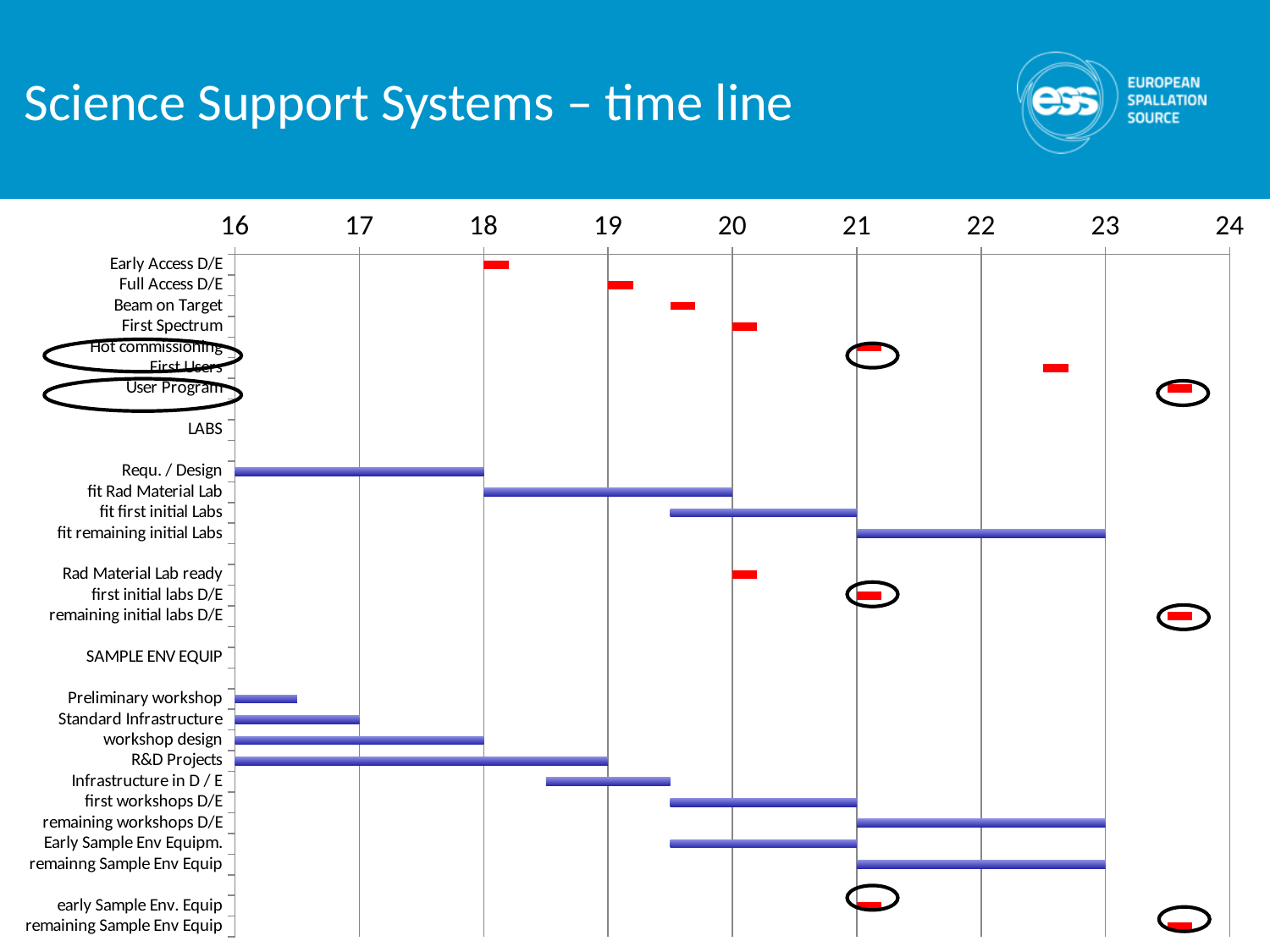
In which year does the Standard Infrastructure bar end? 17 Is the end of the Preliminary workshop bar before or after year 17? before What is the title of the slide containing the chart? Science Support Systems – time line In which year does the Requ. / Design bar end? 18 At which year is the Early Access D/E milestone marker placed? 18 What is the first year label shown on the horizontal axis? 16 In which year does the fit Rad Material Lab bar start? 18 Which bar is longer, R&D Projects or Standard Infrastructure? R&D Projects In which year does the fit remaining initial Labs bar end? 23 At which year is the Hot commissioning milestone marker placed? 21 In which year does the R&D Projects bar end? 19 What kind of chart is shown on the slide? bar chart